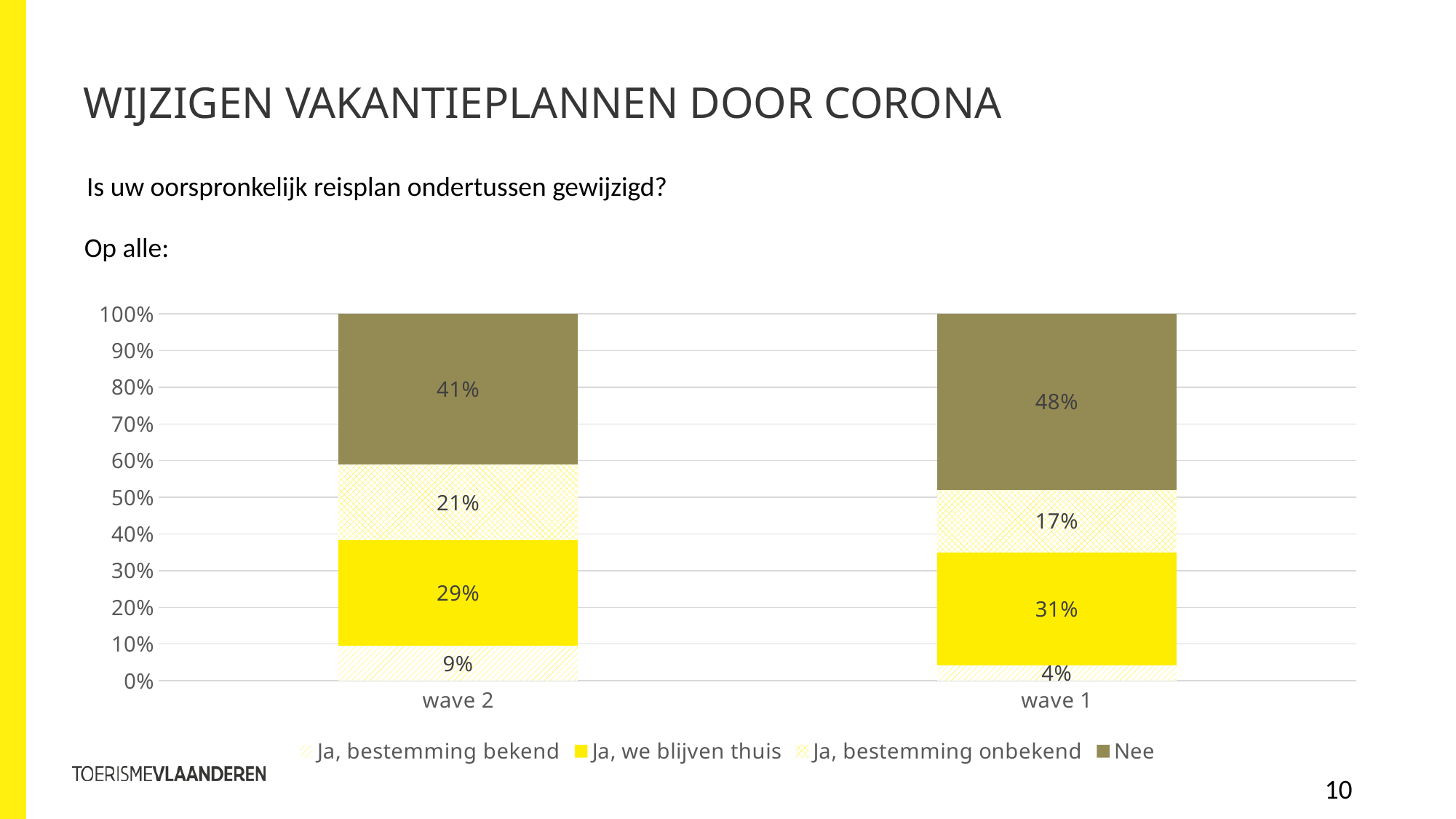
How many categories (waves) are shown on the x axis? 2 What is the value for "Ja, we blijven thuis" in wave 1? 31% What type of chart is shown on the slide? Stacked bar chart Which answer category has the largest share in wave 1? Nee Which wave has the larger share for "Ja, bestemming onbekend"? wave 2 How many series does the legend list? 4 What is the combined share of all "Ja" answers in wave 2? 59% Which answer category has the smallest share in wave 2? Ja, bestemming bekend What percentage of respondents in wave 2 answered "Nee"? 41% What is the value for "Ja, bestemming onbekend" in wave 2? 21% What is the value for "Ja, bestemming bekend" in wave 1? 4% What is the difference between the "Nee" share in wave 1 and in wave 2? 7 percentage points